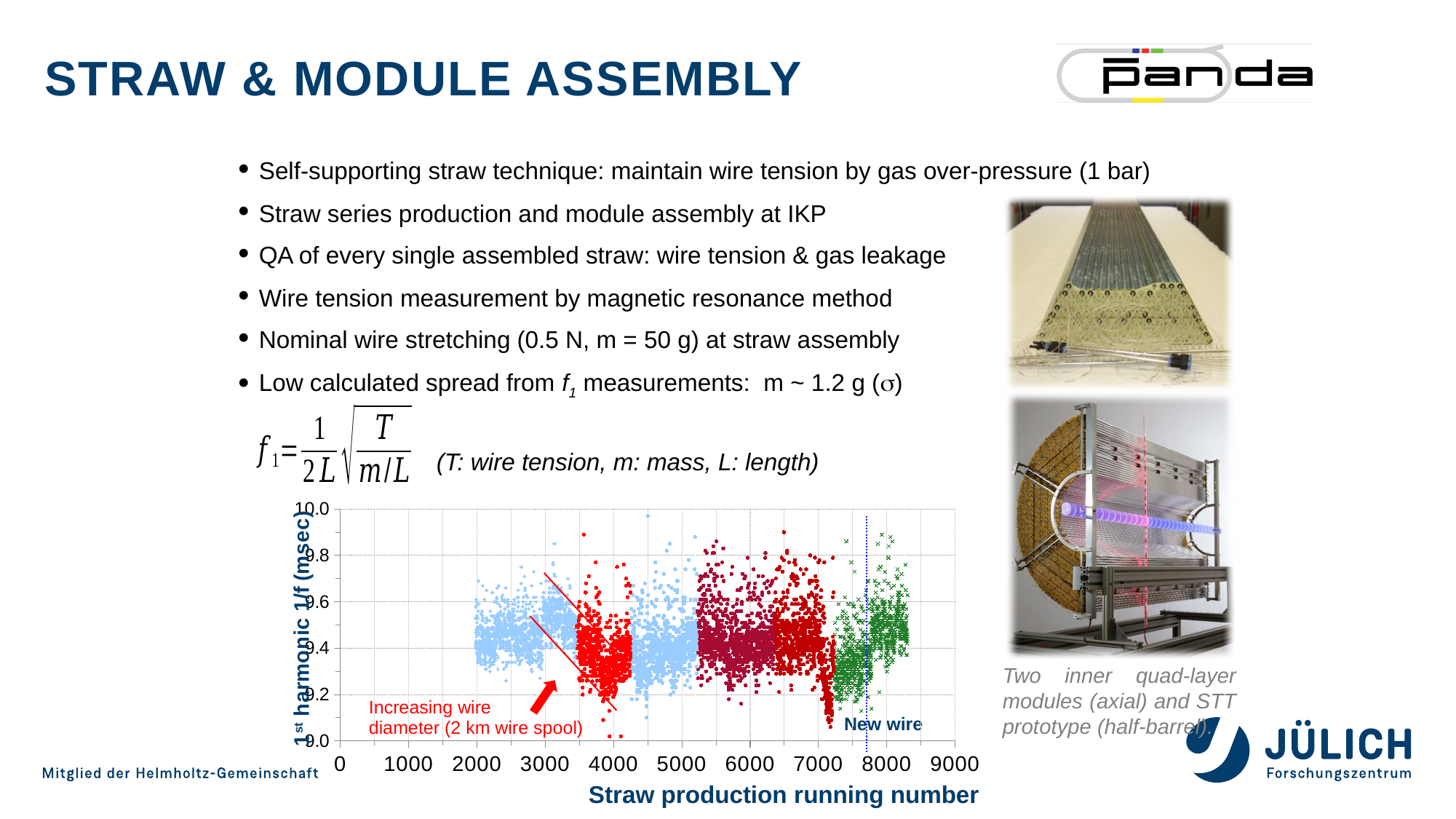
Are the plotted 1st harmonic values for straws around running number 8000 greater or less than 10.0? less What kind of chart is shown at the bottom of the slide? scatter chart What is the title of the y axis of the chart? 1st harmonic 1/f (msec) Are the plotted 1st harmonic values for straws around running number 2500 greater or less than 9.0? greater Are the plotted 1st harmonic values for straws around running number 6000 greater or less than 9.0? greater What is the title of the x axis of the chart? Straw production running number